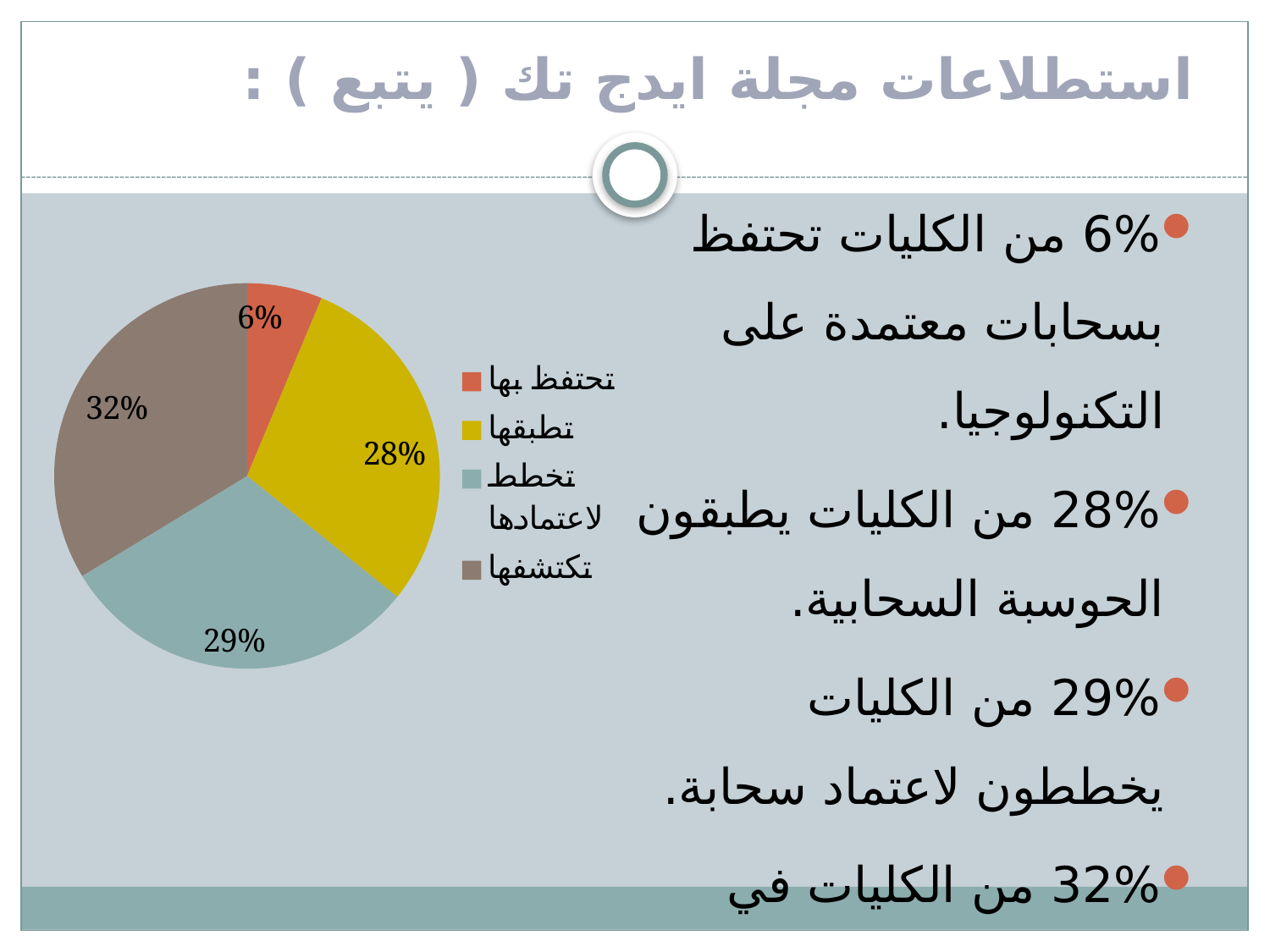
Which is larger, the تكتشفها slice or the تطبقها slice? تكتشفها What percentage of the pie chart is labelled تطبقها? 28% What percentage of the pie chart is labelled تكتشفها? 32% What percentage of the pie chart is labelled تخطط لاعتمادها? 29% Which category has the smallest slice of the pie chart? تحتفظ بها How many slices does the pie chart have? 4 What is the difference between the تخطط لاعتمادها slice and the تطبقها slice? 1% What percentage of the pie chart is labelled تحتفظ بها? 6% Which category has the largest slice of the pie chart? تكتشفها What is the difference between the تكتشفها slice and the تحتفظ بها slice? 26% What type of chart is shown on the slide? pie chart What colour is the تطبقها slice in the pie chart? yellow